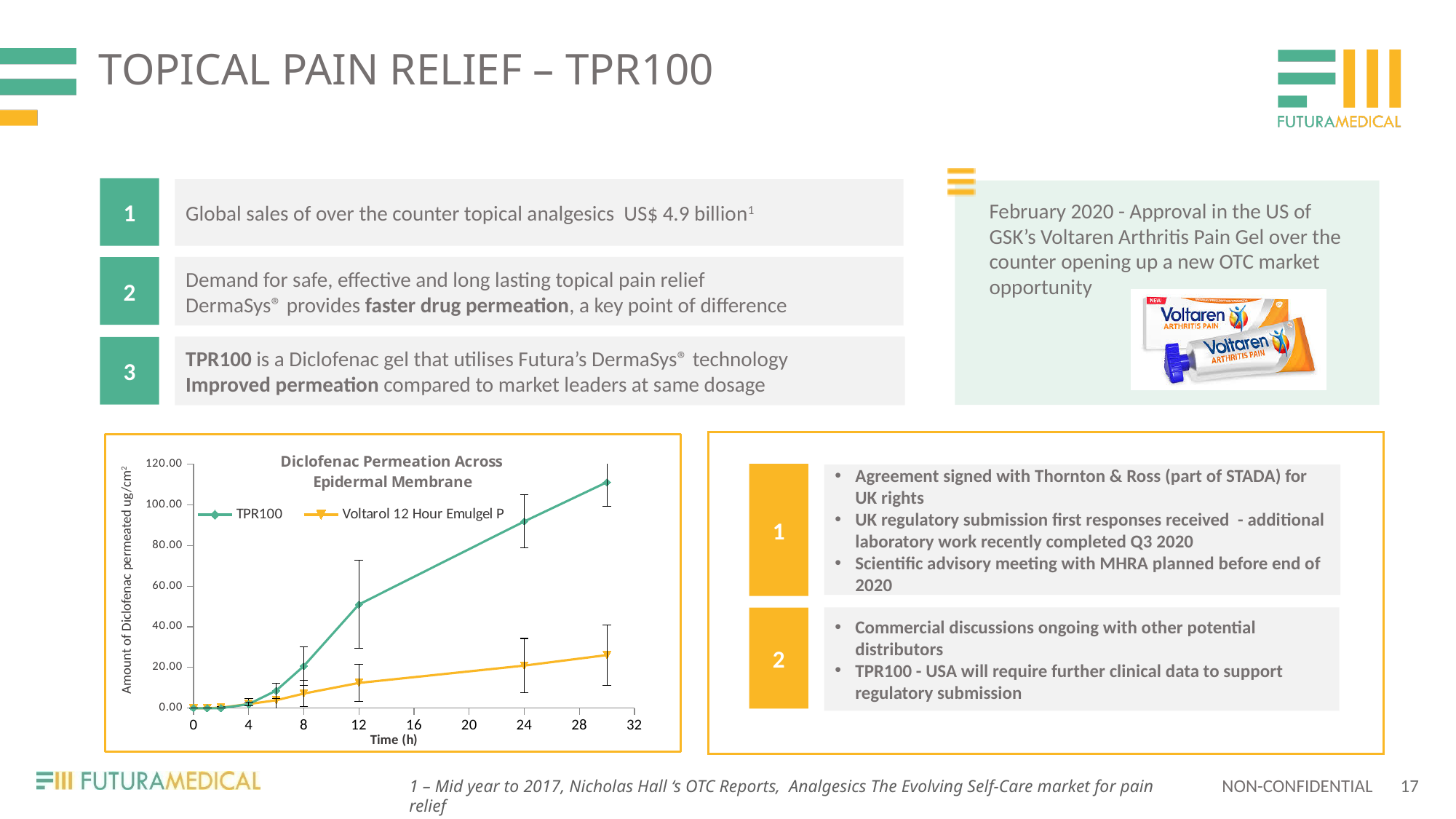
At 24 hours, which series has the larger value, TPR100 or Voltarol 12 Hour Emulgel P? TPR100 How many series does the chart legend list? 2 What is the label of the x axis of the chart? Time (h) Does the TPR100 line rise or fall as time increases along the x axis? rise What is the title of the chart? Diclofenac Permeation Across Epidermal Membrane Is the value for TPR100 at 12 hours greater or less than 40? greater Which series reaches the highest value on the chart? TPR100 Is the value for Voltarol 12 Hour Emulgel P at 30 hours greater or less than 40? less Is the value for TPR100 at 30 hours greater or less than 100? greater What kind of chart is shown on the slide? line chart What are the two series named in the chart legend? TPR100 and Voltarol 12 Hour Emulgel P